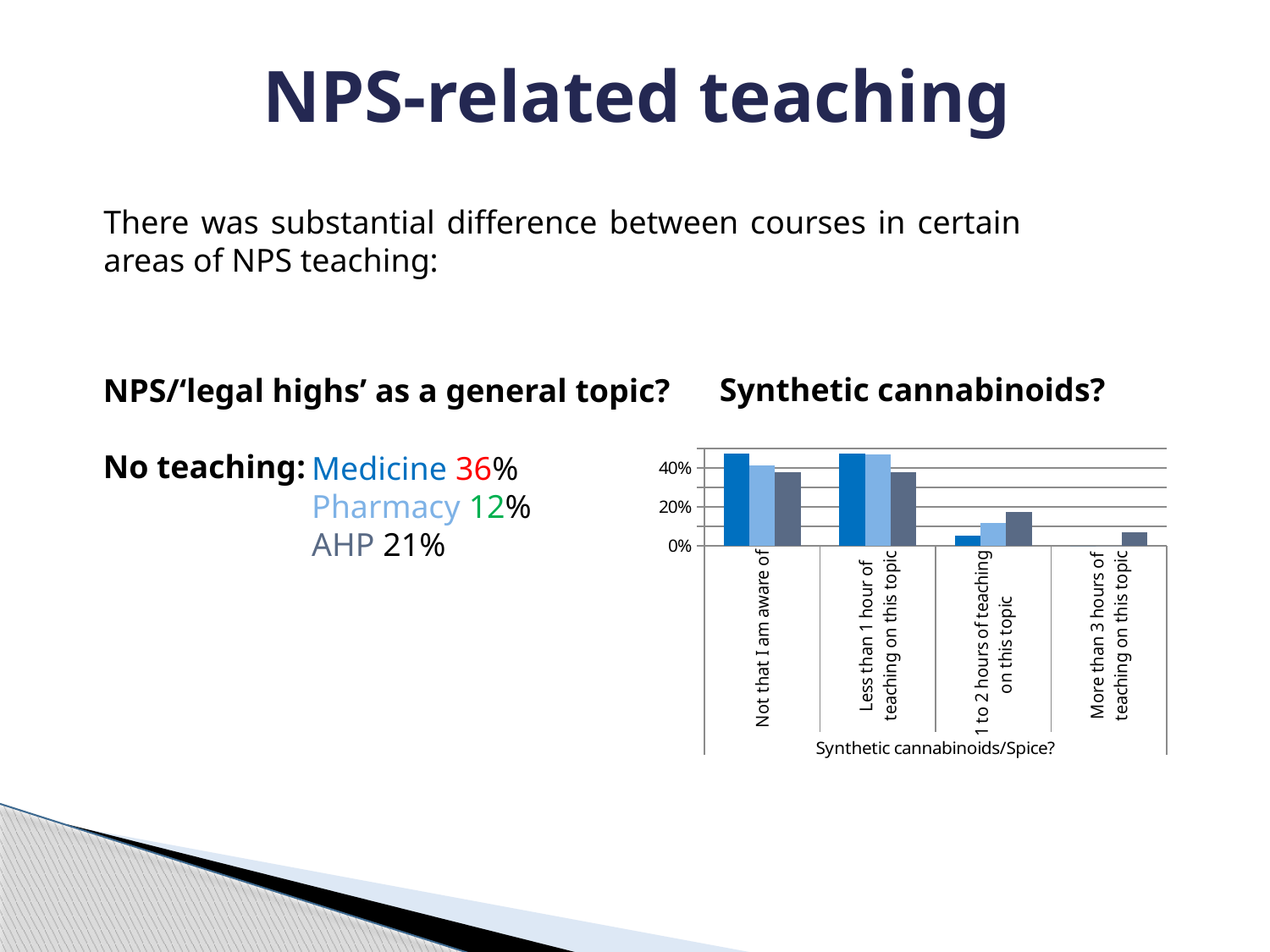
Do the bar values generally rise or fall moving from left to right along the x axis? fall Is the value of the grey bar for 'More than 3 hours of teaching on this topic' greater or less than 20%? less Is the value of the dark blue bar for 'Less than 1 hour of teaching on this topic' greater or less than 40%? greater Which category has the lowest bars overall? More than 3 hours of teaching on this topic Is the value of the dark blue bar for '1 to 2 hours of teaching on this topic' greater or less than 20%? less How many bars are shown for the category 'Not that I am aware of'? 3 What is the highest tick value shown on the vertical axis? 40% What is the axis title printed below the categories of the chart? Synthetic cannabinoids/Spice? How many categories are shown on the x axis of the chart? 4 What kind of chart is shown on the slide? bar chart In the category '1 to 2 hours of teaching on this topic', which bar is larger, the dark blue bar or the grey bar? the grey bar